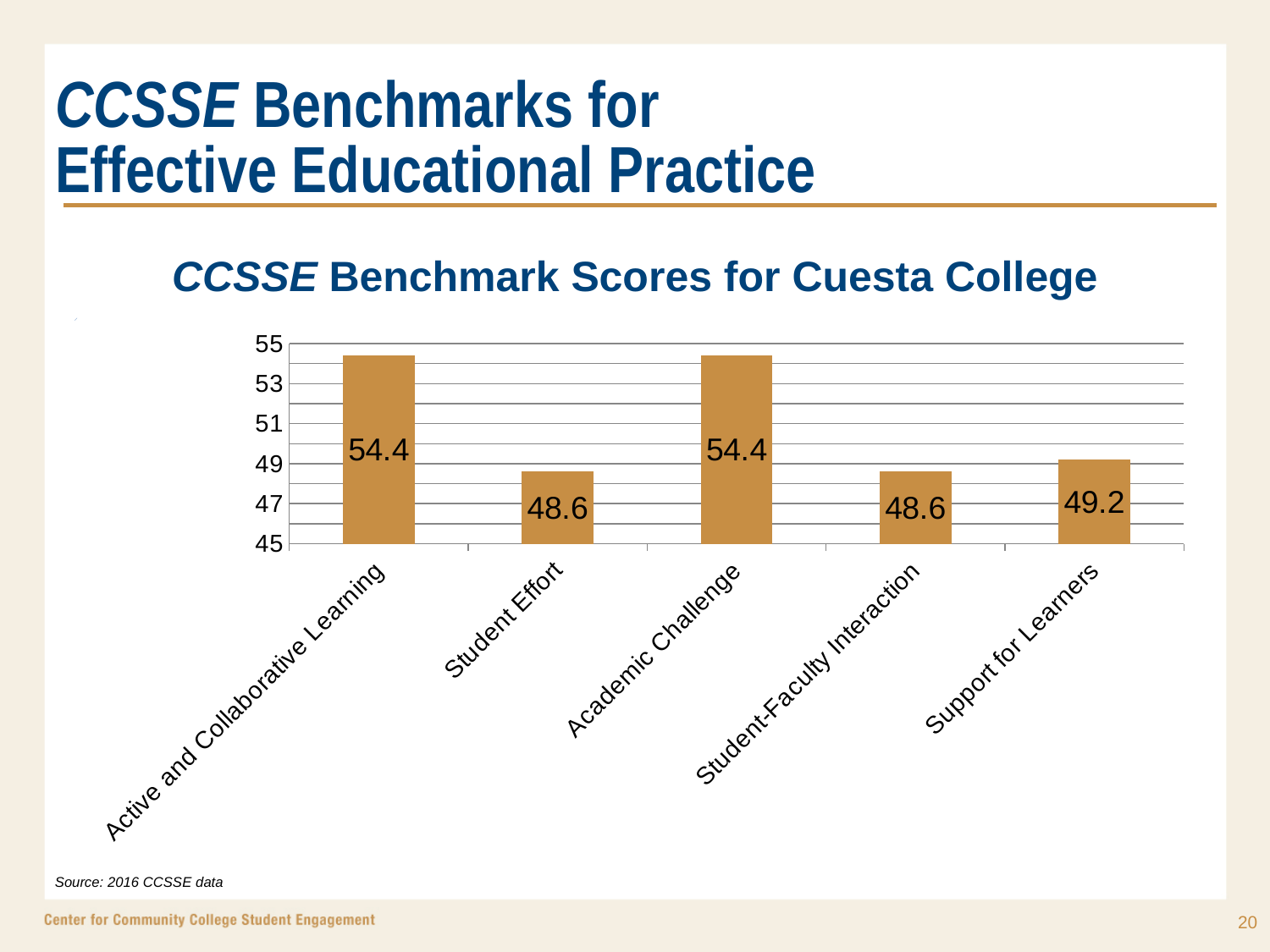
How many benchmark categories are shown in the chart? 5 What is the benchmark score for Student-Faculty Interaction? 48.6 What kind of chart is used to show the CCSSE benchmark scores? Bar chart What is the difference between the scores for Academic Challenge and Student Effort? 5.8 What is the title of the chart? CCSSE Benchmark Scores for Cuesta College Is the score for Active and Collaborative Learning greater or less than 53? greater What is the CCSSE benchmark score for Active and Collaborative Learning? 54.4 What is the difference between the scores for Support for Learners and Student-Faculty Interaction? 0.6 Which has the higher score, Support for Learners or Student Effort? Support for Learners What is the benchmark score for Academic Challenge? 54.4 What is the benchmark score for Student Effort? 48.6 What is the benchmark score for Support for Learners? 49.2